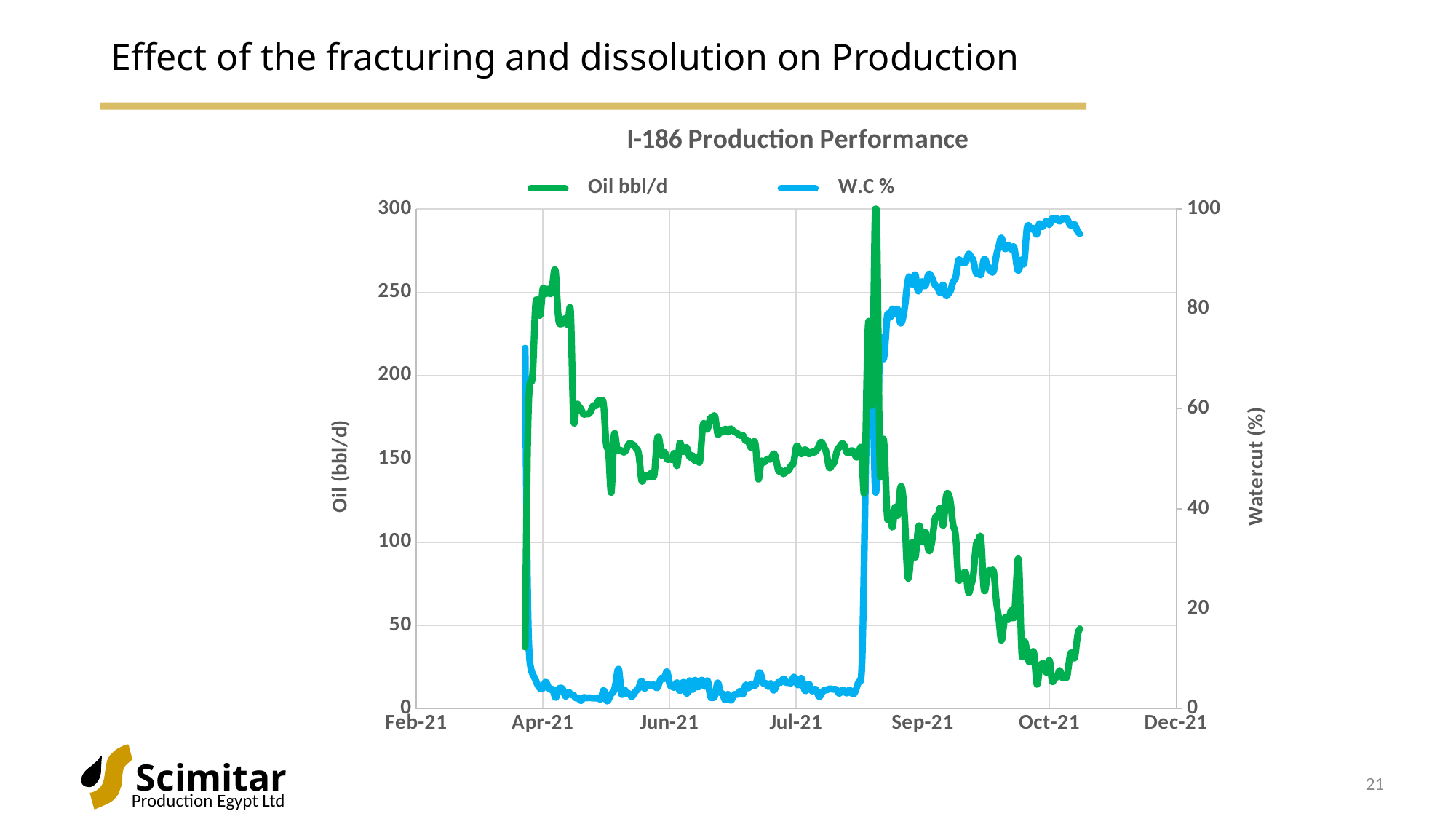
Does the Oil bbl/d series rise or fall between Apr-21 and Jun-21? fall Does the W.C % series rise or fall between Sep-21 and Oct-21? rise Is the value of Oil bbl/d at Oct-21 greater or less than 50? less Is the value of W.C % at Jul-21 greater or less than 20? less Is the value of W.C % at Jun-21 greater or less than 20? less Which series is drawn in blue? W.C % Does the Oil bbl/d series rise or fall between Sep-21 and Oct-21? fall What kind of chart is shown on the slide? Line chart What is the title of the chart? I-186 Production Performance How many series does the legend list? 2